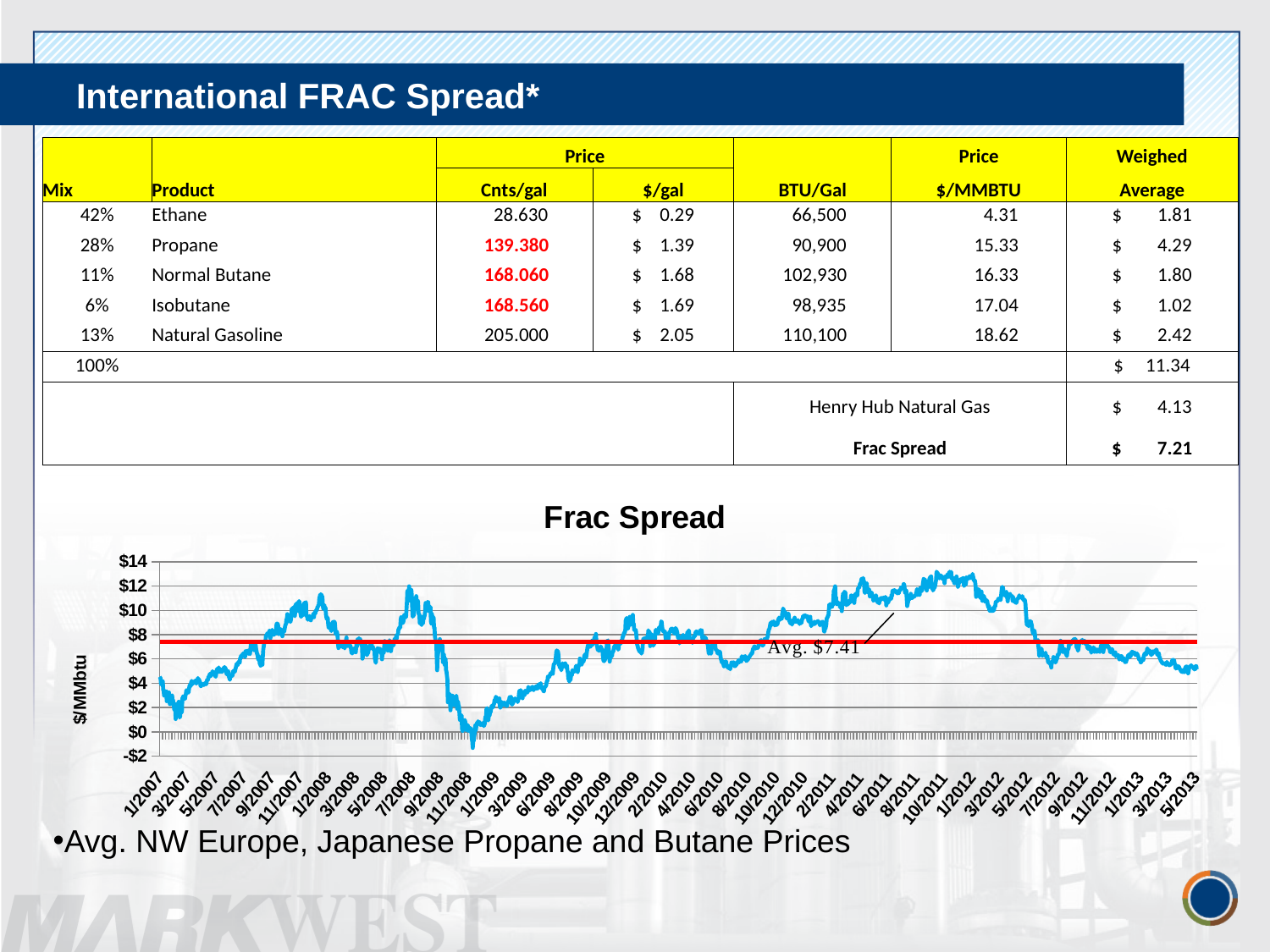
Which is larger on the Frac Spread chart: the value around 1/2012 or the value at 5/2013? 1/2012 What is the label on the vertical axis of the Frac Spread chart? $/MMbtu Is the average frac spread marked on the chart greater or less than $8? less Does the Frac Spread line rise or fall between 11/2008 and 1/2012 overall? rise Does the Frac Spread line rise or fall between 1/2012 and 5/2013? fall What is the title of the chart on the slide? Frac Spread Is the Frac Spread value around 1/2012 greater or less than $10? greater Is the Frac Spread value at 5/2013 greater or less than $8? less What average value is marked by the red horizontal line on the Frac Spread chart? $7.41 What kind of chart is the Frac Spread chart? line chart What is the highest tick value shown on the vertical axis of the Frac Spread chart? $14